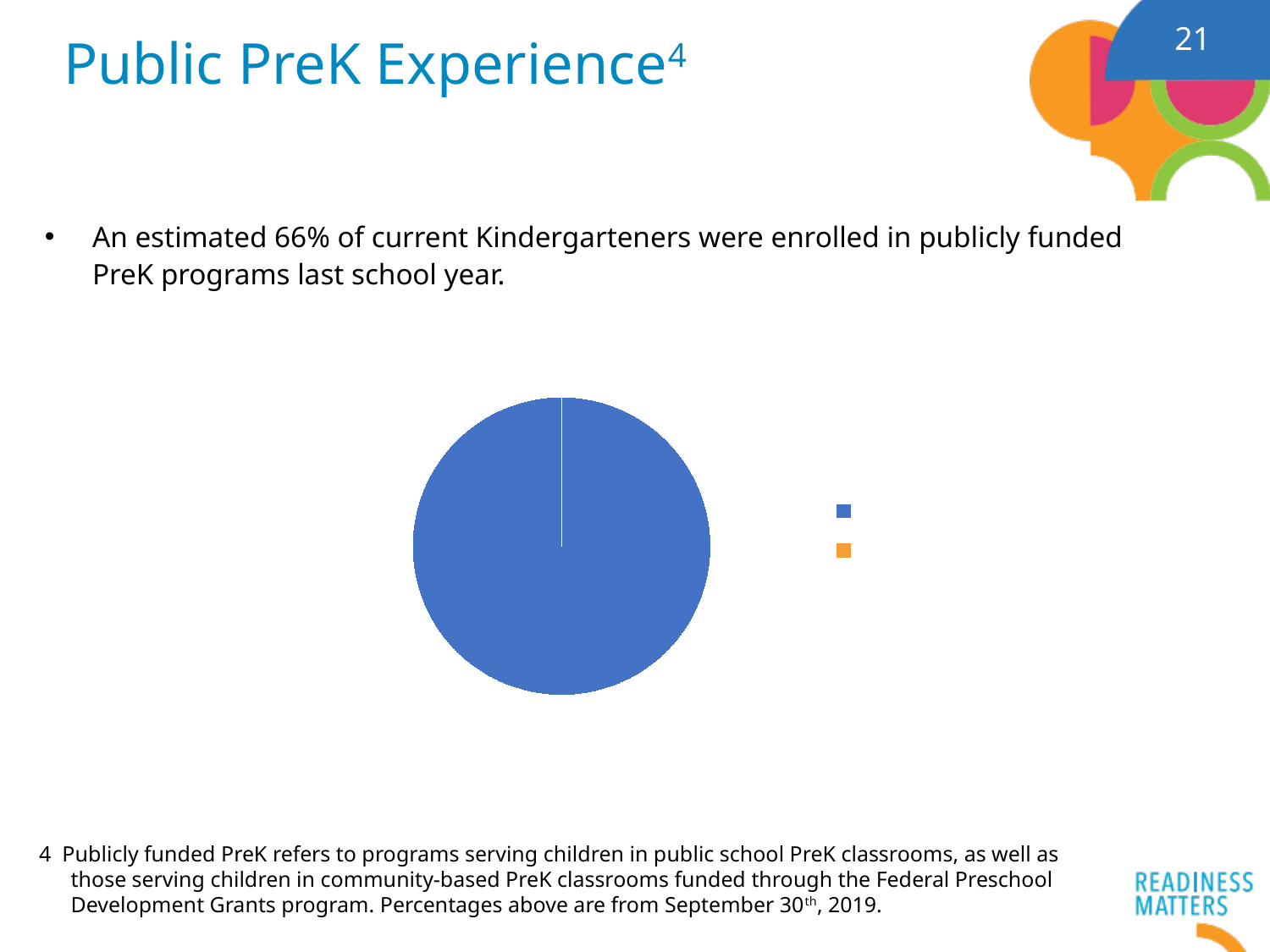
What colour is the largest slice of the pie chart? blue What kind of chart is shown on the slide? pie chart Which slice of the pie chart is larger, the blue one or the orange one? blue What colours are used for the two legend entries of the pie chart? blue and orange How many entries does the legend of the pie chart list? 2